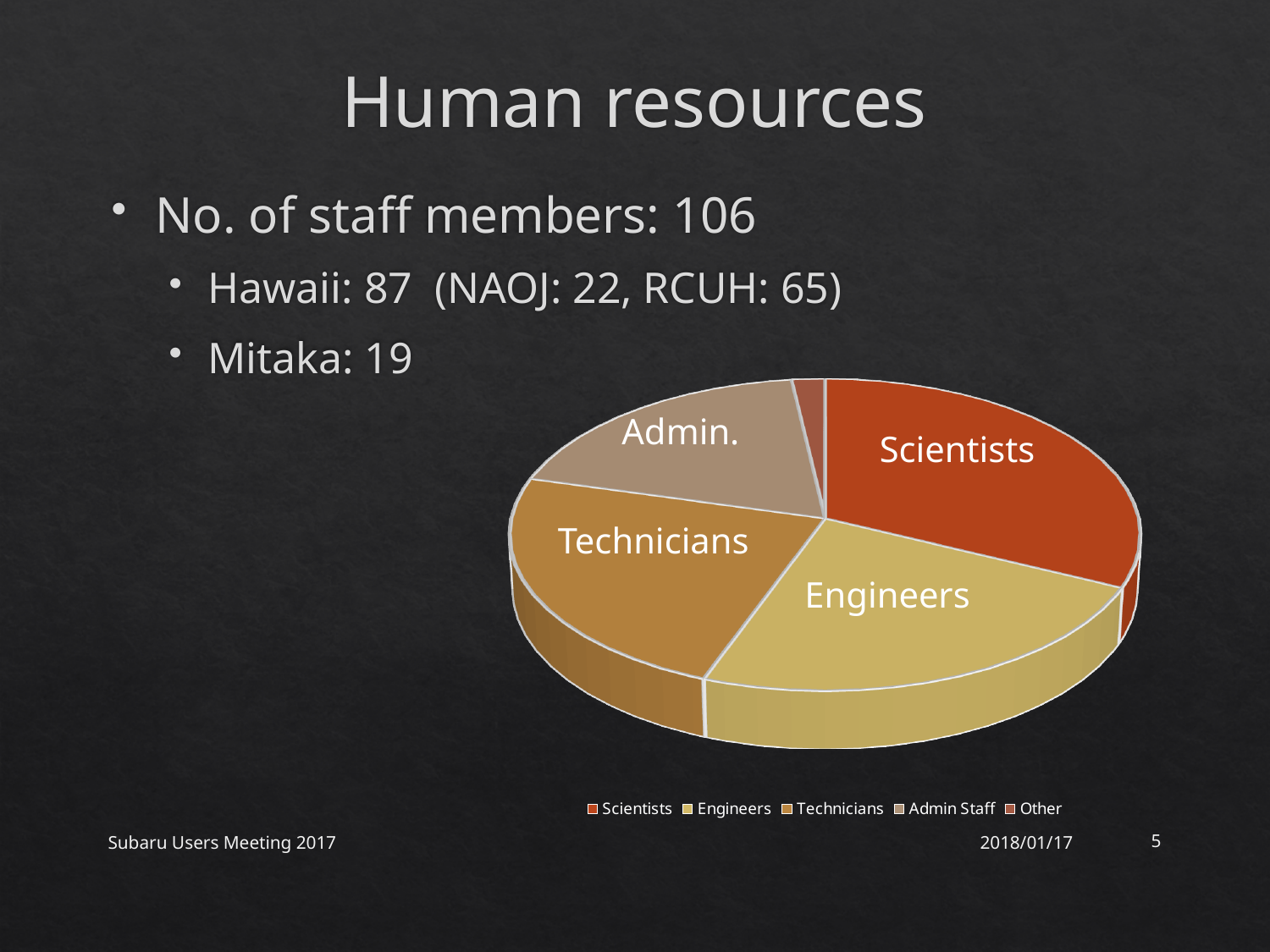
How many slices does the pie chart have? 5 Which legend entry of the pie chart is not labelled directly on a slice? Other Which slice is larger in the pie chart, Technicians or Other? Technicians Which slice is larger in the pie chart, Admin Staff or Other? Admin Staff Which slice is larger in the pie chart, Engineers or Admin Staff? Engineers What kind of chart is shown on the slide? pie chart What are the legend entries of the pie chart, in order? Scientists, Engineers, Technicians, Admin Staff, Other How many entries does the legend of the pie chart list? 5 Which category has the smallest slice in the pie chart? Other